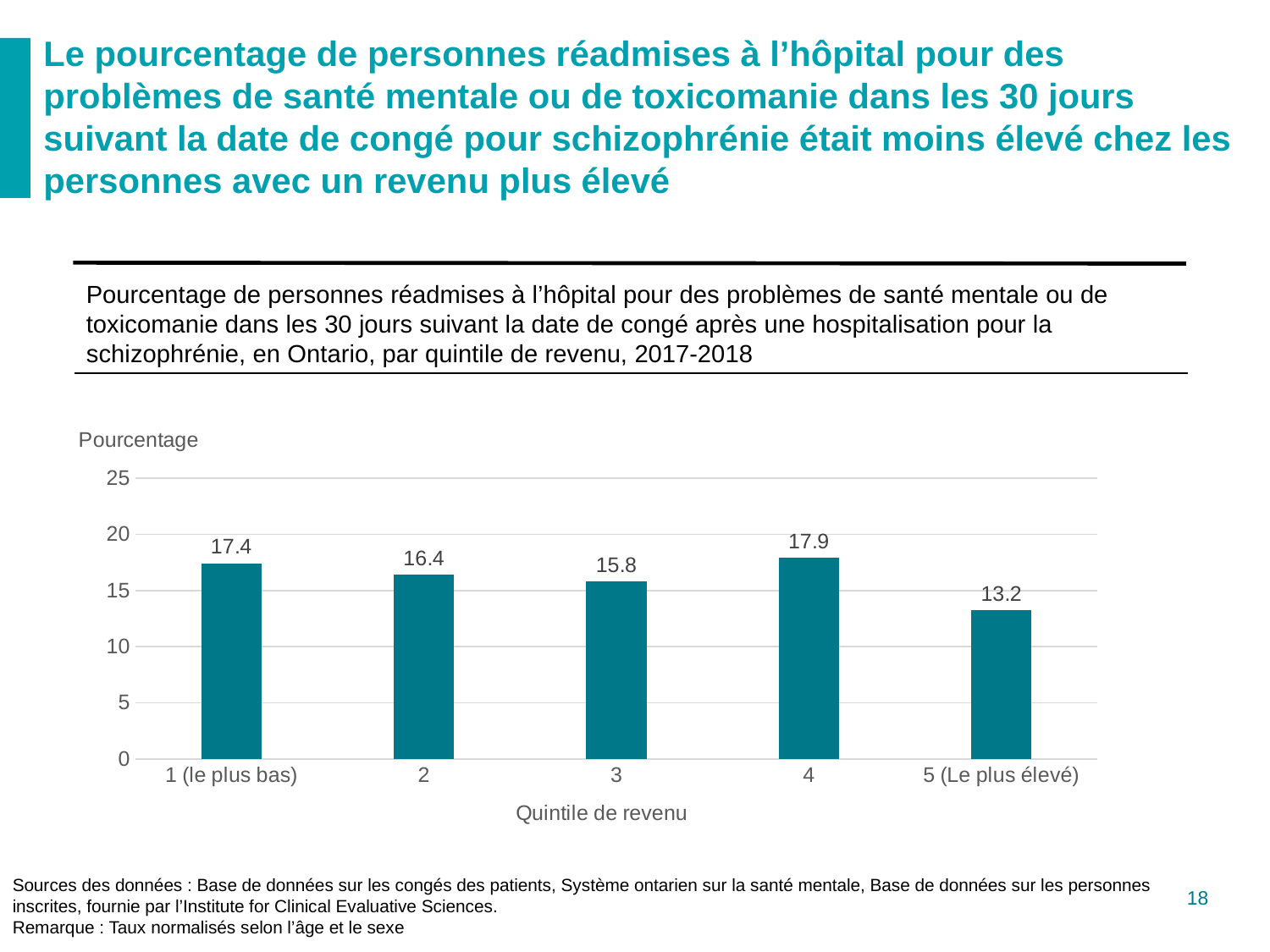
What is the difference between the values for quintile 4 and quintile 5 (Le plus élevé)? 4.7 What is the label of the x axis? Quintile de revenu What kind of chart is shown on the slide? bar chart What is the difference between the values for quintile 1 (le plus bas) and quintile 2? 1.0 Which income quintile has the lowest value? 5 (Le plus élevé) What is the value for income quintile 3? 15.8 Which income quintile has the highest value? 4 Is the value for quintile 5 (Le plus élevé) greater or less than 15? less How many income quintiles are shown on the x axis? 5 Which is larger, the value for quintile 2 or the value for quintile 3? 2 What is the value for income quintile 5 (Le plus élevé)? 13.2 What is the value for income quintile 1 (le plus bas)? 17.4